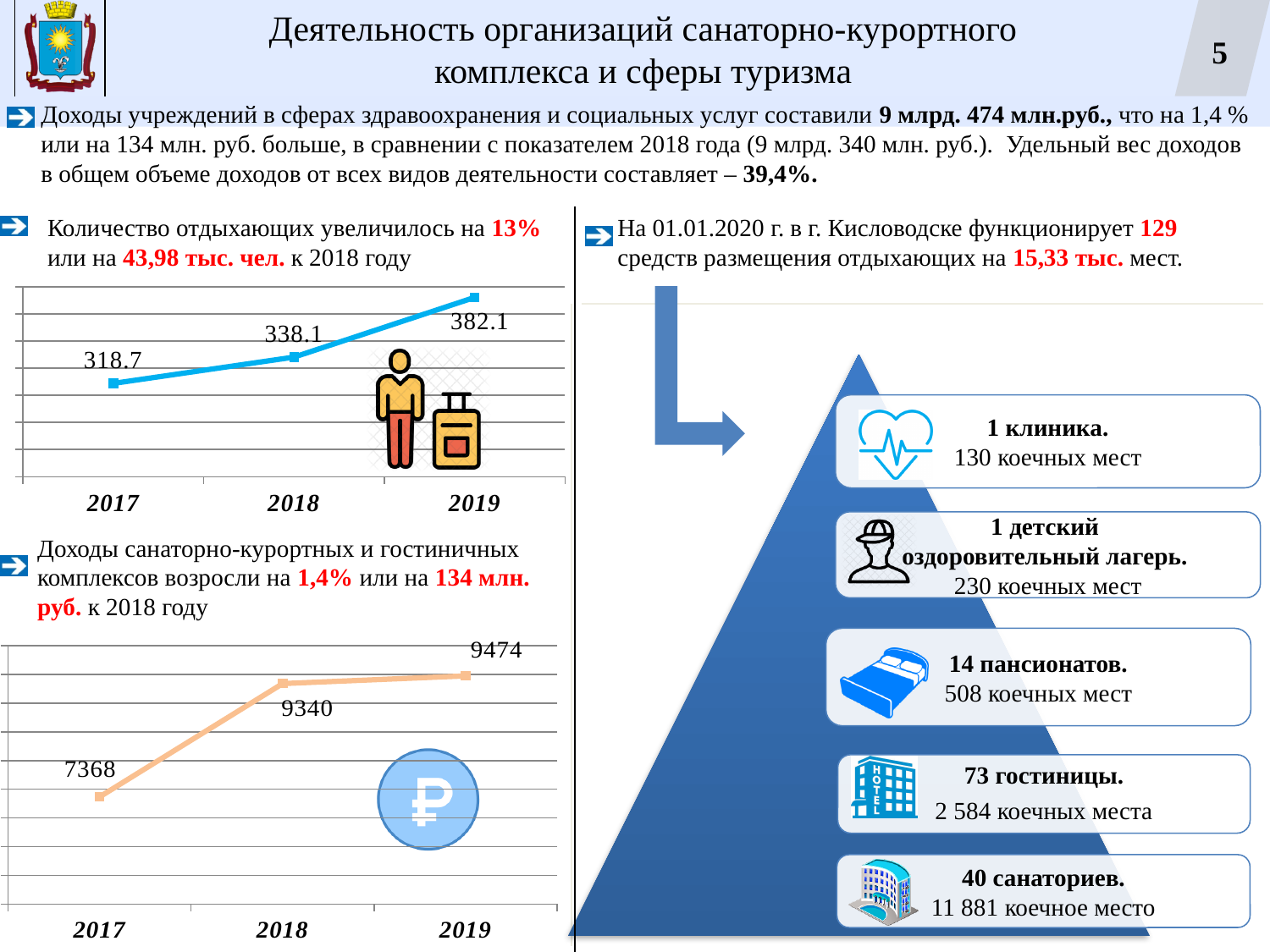
In the lower line chart on the left side of the slide, what is the value for 2018? 9340 In the upper line chart on the left side of the slide, which year has the highest value? 2019 In the upper line chart on the left side of the slide, what is the value for 2019? 382.1 In the lower line chart on the left side of the slide, what is the difference between the 2019 and 2018 values? 134 What kind of chart is the upper chart on the left side of the slide? line chart In the lower line chart on the left side of the slide, what is the value for 2017? 7368 In the lower line chart on the left side of the slide, which year has the lowest value? 2017 In the upper line chart on the left side of the slide, what is the difference between the 2019 and 2018 values? 44 In the upper line chart on the left side of the slide, what is the value for 2017? 318.7 In the lower line chart on the left side of the slide, how many data points are plotted? 3 In the upper line chart on the left side of the slide, do the values rise or fall from 2017 to 2019? rise In the lower line chart on the left side of the slide, is the value for 2018 larger or smaller than the value for 2017? larger